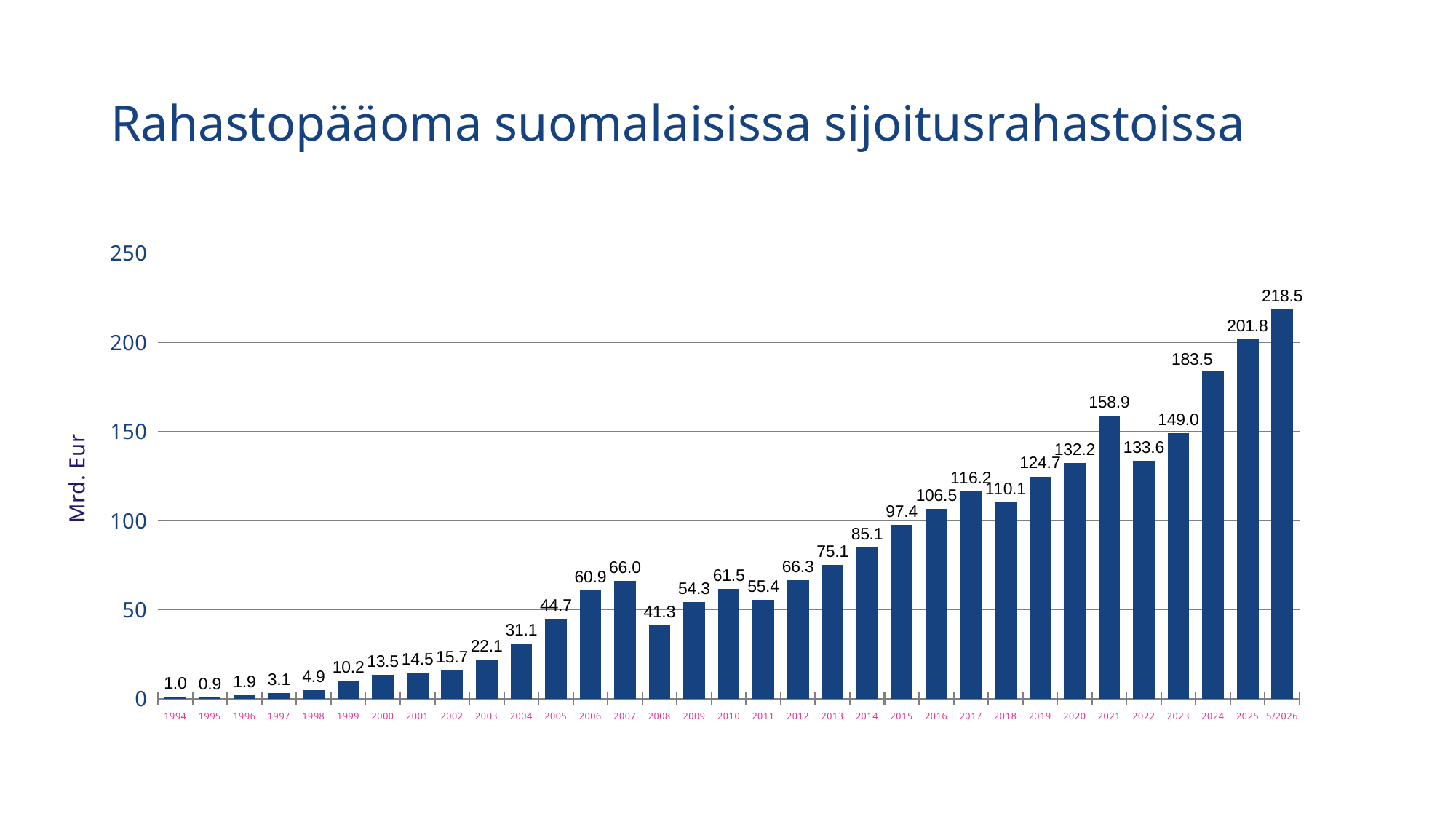
Which is larger, the value for 2007 or the value for 2009? 2007 What is the title of the chart? Rahastopääoma suomalaisissa sijoitusrahastoissa What is the value for 5/2026? 218.5 What is the value for 2008? 41.3 Is the value for 2019 greater or less than 100? greater What kind of chart is shown on the slide? bar chart Which year has the lowest value? 1995 What is the label of the vertical axis? Mrd. Eur What is the difference between the values for 2025 and 2024? 18.3 How many bars are shown in the chart? 33 What is the value for 2021? 158.9 Which category has the highest value? 5/2026